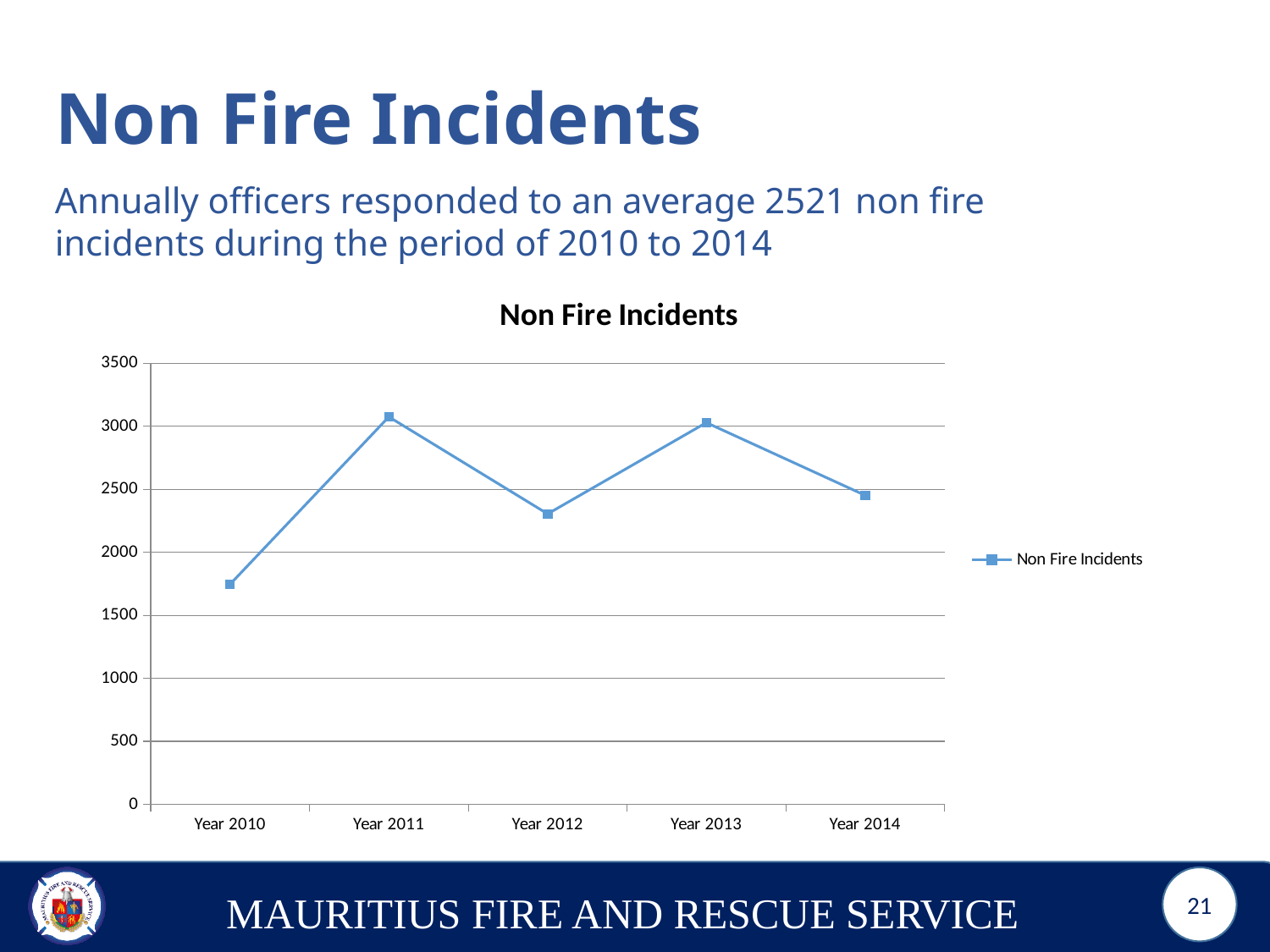
Is the value for Year 2012 greater or less than 2500? less What kind of chart is shown on the slide? line chart Which is larger, the value for Year 2012 or the value for Year 2013? Year 2013 Which year has the lowest number of non fire incidents? Year 2010 Is the value for Year 2010 greater or less than 2000? less Is the value for Year 2011 greater or less than 3000? greater What is the title of the chart? Non Fire Incidents Does the value rise or fall from Year 2013 to Year 2014? fall How many years are plotted on the x axis of the chart? 5 How many series does the chart legend list? 1 Which is larger, the value for Year 2010 or the value for Year 2011? Year 2011